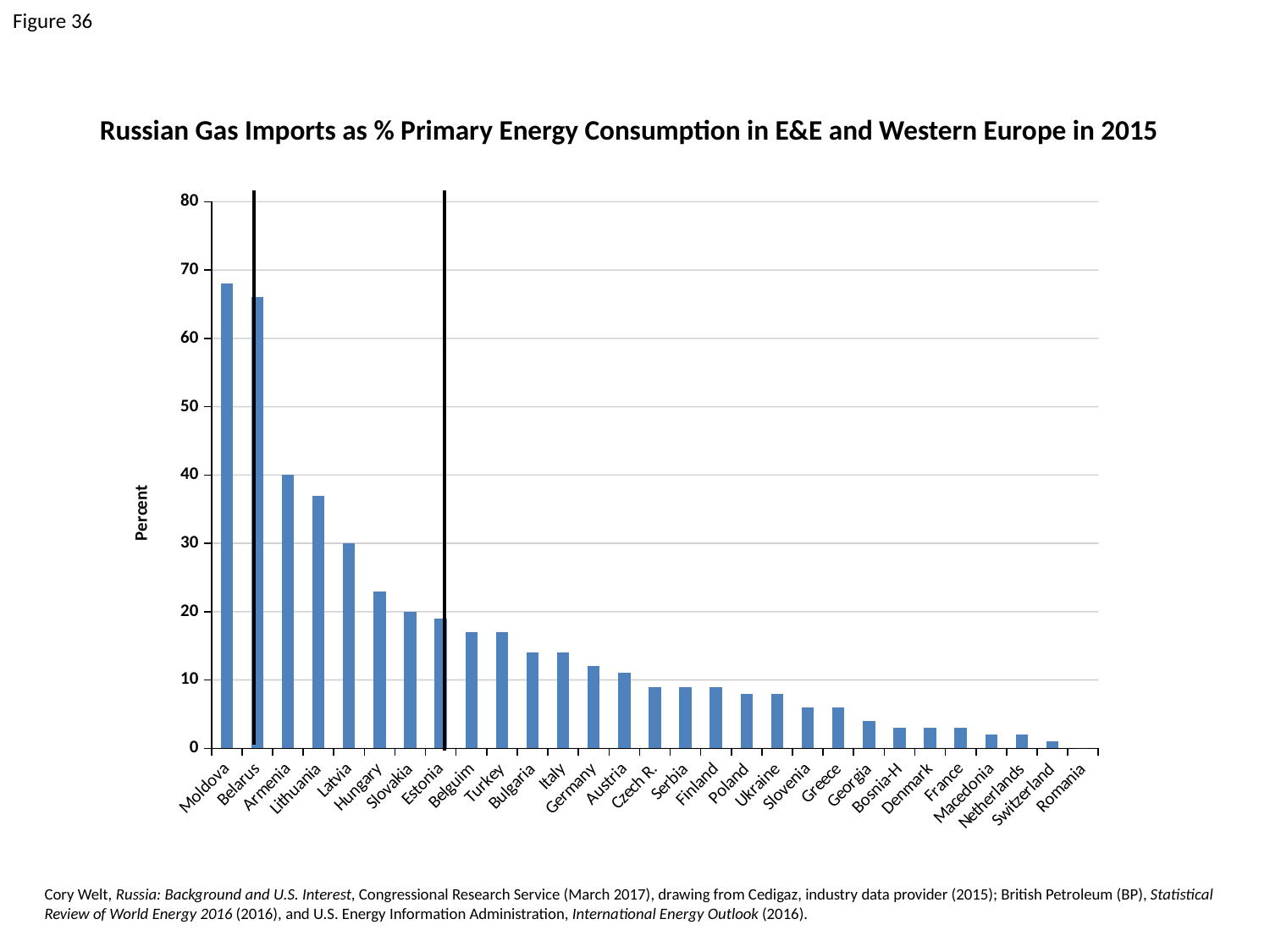
Do the values generally rise or fall moving from left to right along the x axis? fall Is the value for Switzerland greater or less than 10? less What is the label on the vertical axis? Percent What kind of chart is shown on the slide? bar chart Which country has the highest value in the chart? Moldova Is the value for Lithuania greater or less than 40? less Which country has the lowest value in the chart? Romania Is the value for Belgium greater or less than 20? less Which has a larger value, Hungary or Slovakia? Hungary How many countries are shown on the x axis? 29